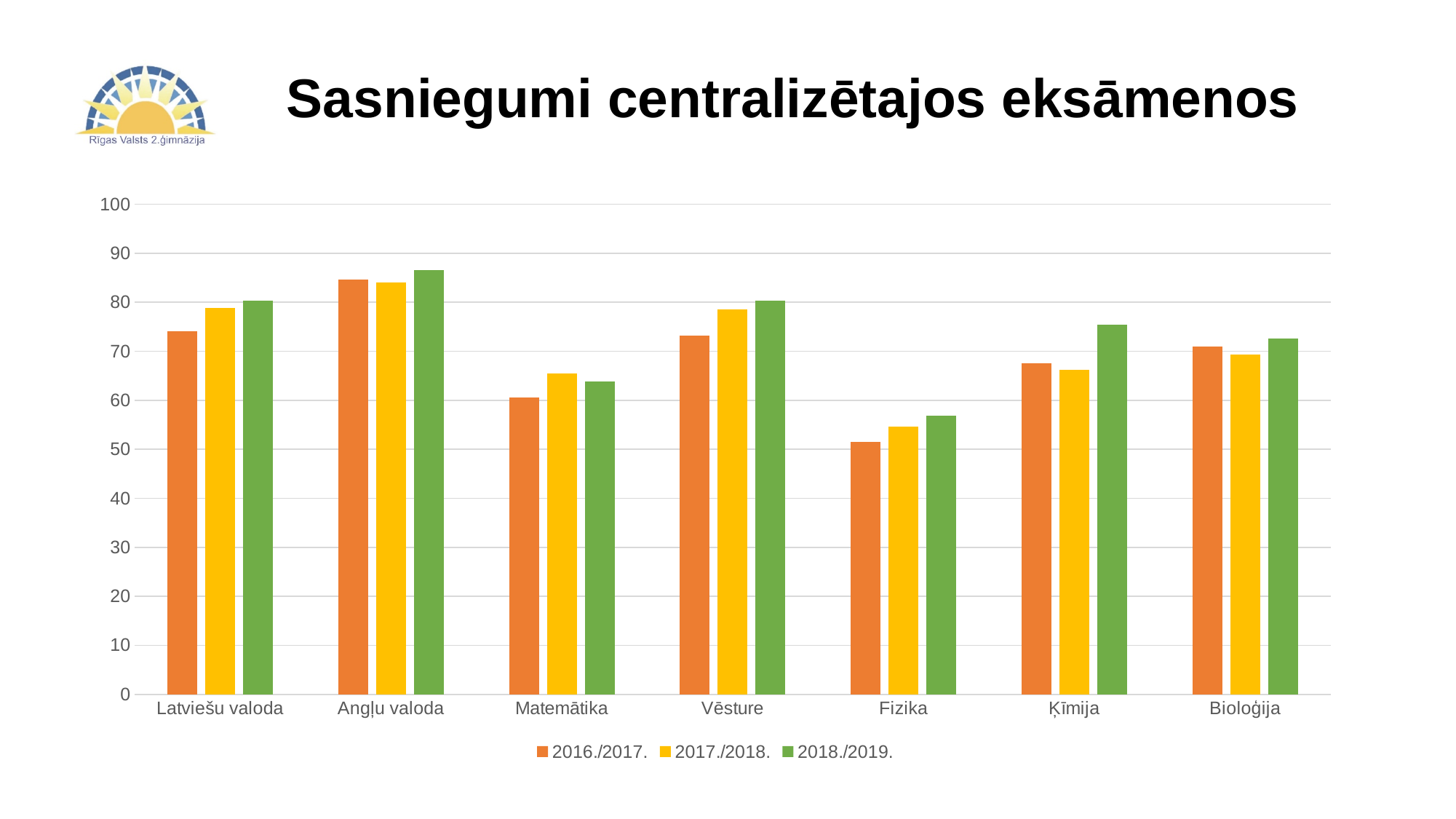
How many series does the legend list? 3 Which subject has the highest value for the 2018./2019. series? Angļu valoda Is the value for Fizika in 2016./2017. greater or less than 60? less Which subject has the lowest value for the 2016./2017. series? Fizika Which is larger for the 2018./2019. series: Matemātika or Fizika? Matemātika What kind of chart is shown on the slide? bar chart What is the title of the chart? Sasniegumi centralizētajos eksāmenos Is the value for Angļu valoda in 2018./2019. greater or less than 80? greater Is the value for Ķīmija in 2018./2019. greater or less than 70? greater For Ķīmija, which series has the larger value: 2016./2017. or 2018./2019.? 2018./2019. Do the values for Fizika rise or fall from 2016./2017. to 2018./2019.? rise How many subject categories are shown on the x axis? 7